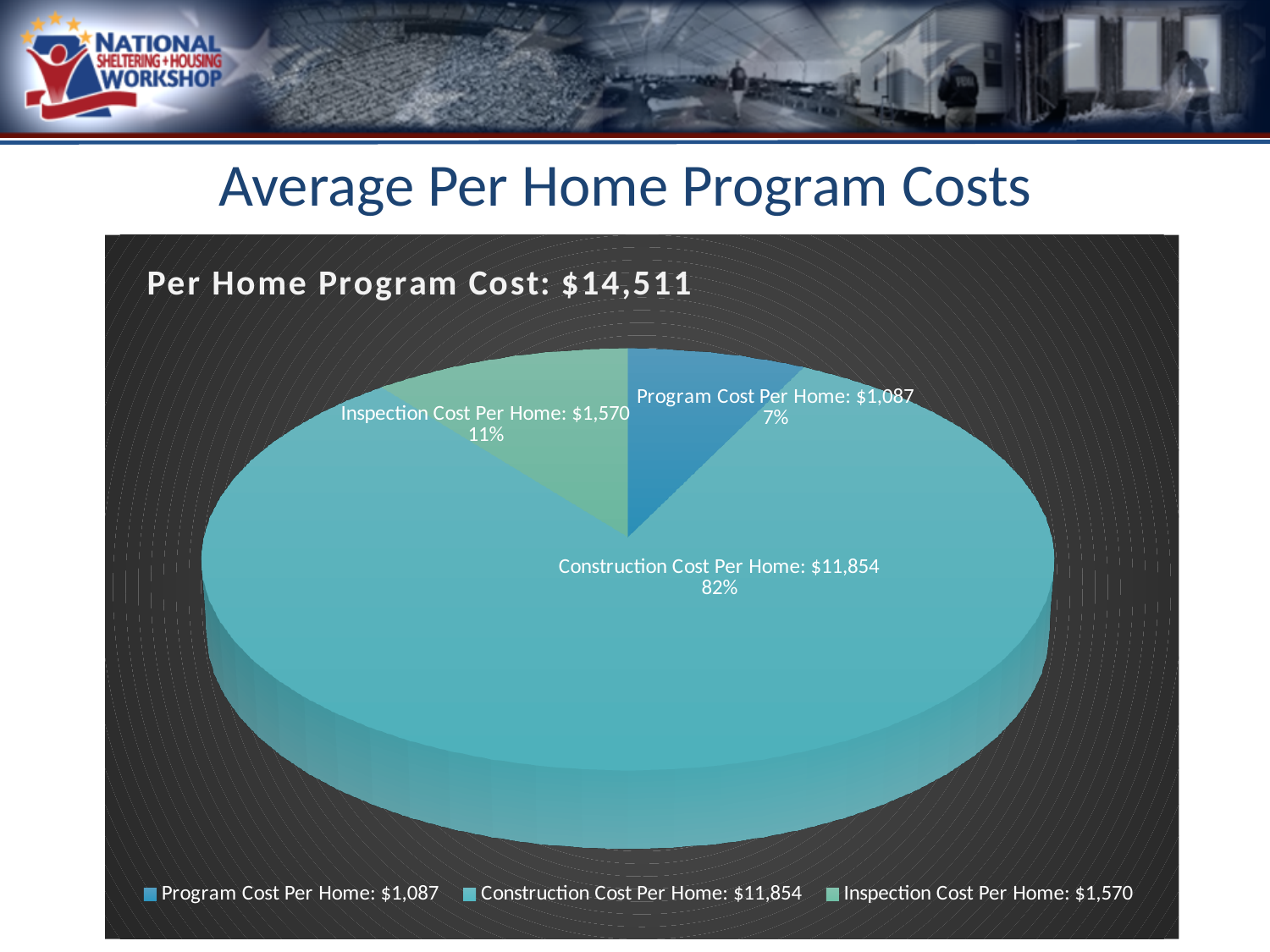
How many slices does the pie chart have? 3 How many entries does the legend list? 3 What is the Inspection Cost Per Home? $1,570 What type of chart is shown on the slide? Pie chart What is the Program Cost Per Home? $1,087 What is the Construction Cost Per Home? $11,854 What is the difference between the Inspection Cost Per Home and the Program Cost Per Home? $483 Which cost category is the largest slice of the pie? Construction Cost Per Home Which cost category is the smallest slice of the pie? Program Cost Per Home What share of the pie does Inspection Cost Per Home represent? 11% What share of the pie does Construction Cost Per Home represent? 82% What is the chart's title? Per Home Program Cost: $14,511